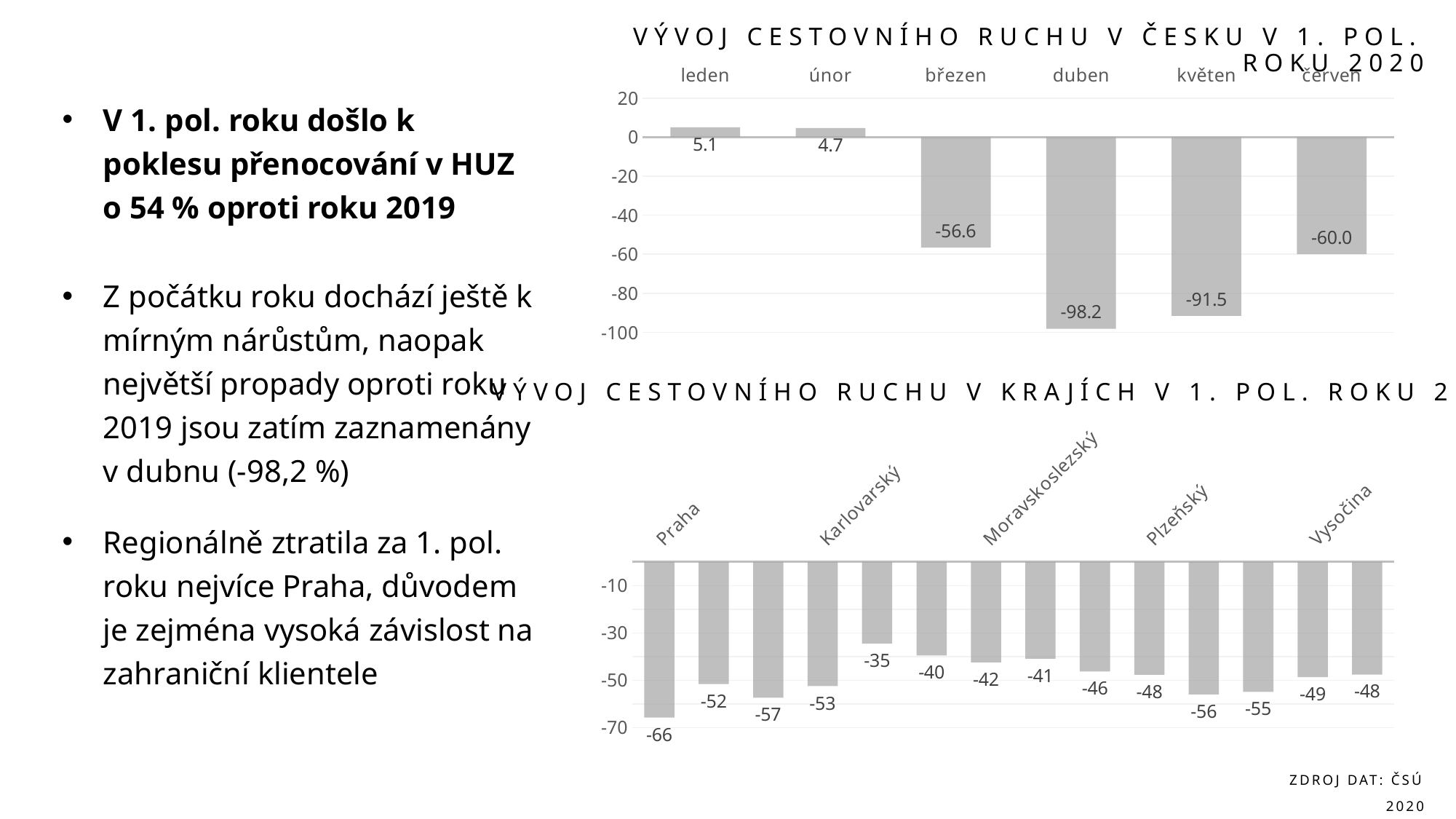
In the top chart (Vývoj cestovního ruchu v Česku v 1. pol. roku 2020), what is the value for leden? 5.1 In the top chart (Vývoj cestovního ruchu v Česku v 1. pol. roku 2020), which month has the lowest value? duben In the bottom chart (Vývoj cestovního ruchu v krajích), which region has the lowest value? Praha In the top chart (Vývoj cestovního ruchu v Česku v 1. pol. roku 2020), what is the difference between the values for březen and duben? 41.6 In the top chart (Vývoj cestovního ruchu v Česku v 1. pol. roku 2020), how many months are plotted? 6 In the top chart (Vývoj cestovního ruchu v Česku v 1. pol. roku 2020), what is the value for duben? -98.2 In the top chart (Vývoj cestovního ruchu v Česku v 1. pol. roku 2020), what is the value for červen? -60.0 In the bottom chart (Vývoj cestovního ruchu v krajích), what is the value for Praha? -66 In the top chart (Vývoj cestovního ruchu v Česku v 1. pol. roku 2020), which month has the highest value? leden In the top chart (Vývoj cestovního ruchu v Česku v 1. pol. roku 2020), which is larger, the value for květen or the value for červen? červen In the bottom chart (Vývoj cestovního ruchu v krajích), how many bars are plotted? 14 What kind of chart is the top chart (Vývoj cestovního ruchu v Česku v 1. pol. roku 2020)? bar chart